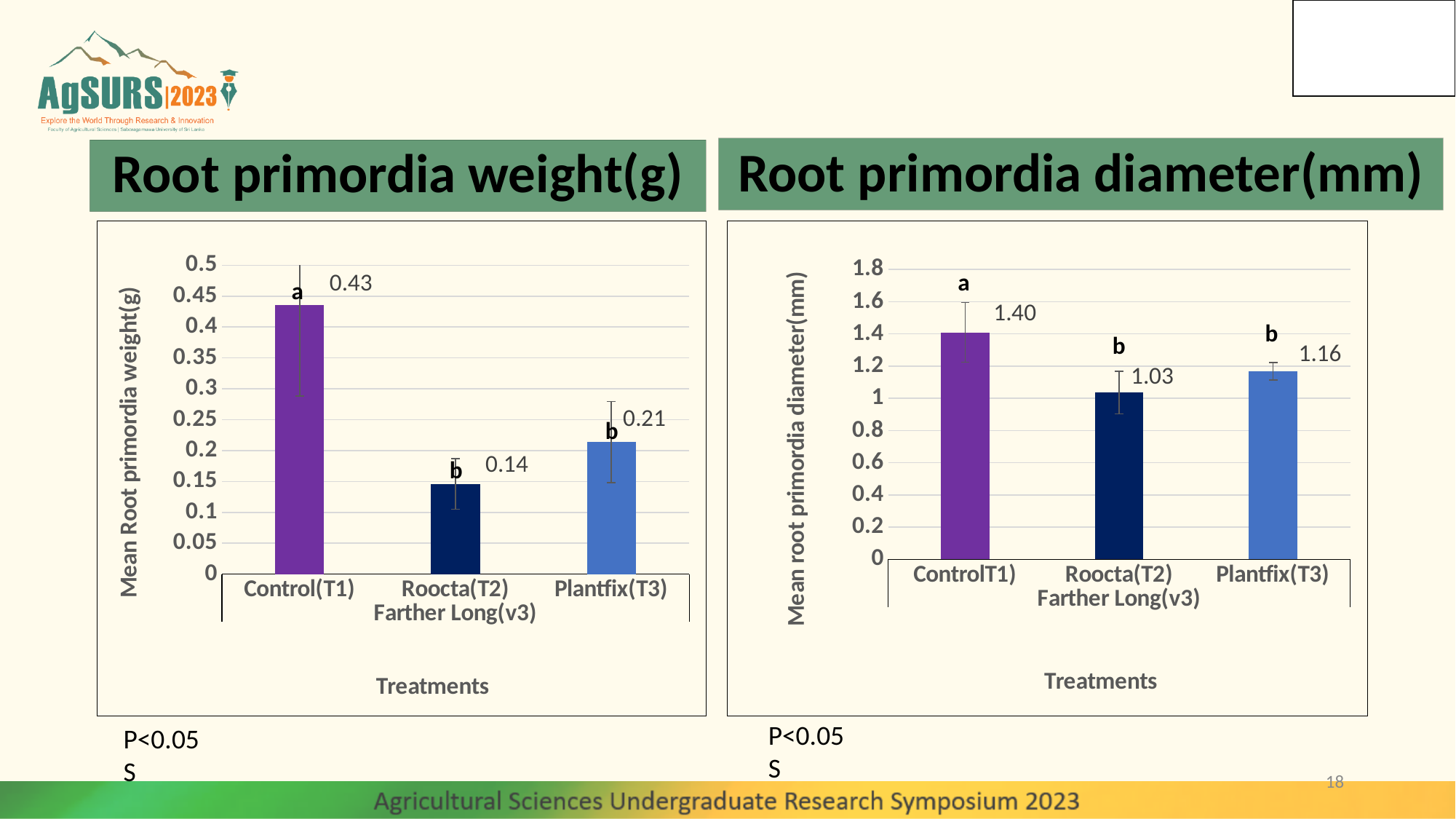
In the Root primordia diameter(mm) chart, what is the difference between the values for ControlT1) and Plantfix(T3)? 0.24 In the Root primordia diameter(mm) chart, which is larger, the value for Roocta(T2) Farther Long(v3) or Plantfix(T3)? Plantfix(T3) In the Root primordia weight(g) chart, what is the value for Plantfix(T3)? 0.21 In the Root primordia weight(g) chart, is the value for Control(T1) greater or less than 0.4? greater How many treatments are shown in the Root primordia diameter(mm) chart? 3 In the Root primordia weight(g) chart, which treatment has the lowest mean root primordia weight? Roocta(T2) Farther Long(v3) In the Root primordia diameter(mm) chart, which treatment has the highest mean root primordia diameter? ControlT1) In the Root primordia diameter(mm) chart, what is the value for Plantfix(T3)? 1.16 In the Root primordia diameter(mm) chart, what is the value for Roocta(T2) Farther Long(v3)? 1.03 What kind of chart is the Root primordia weight(g) chart? bar chart In the Root primordia weight(g) chart, what is the difference between the values for Control(T1) and Roocta(T2) Farther Long(v3)? 0.29 In the Root primordia weight(g) chart, what is the value for Control(T1)? 0.43